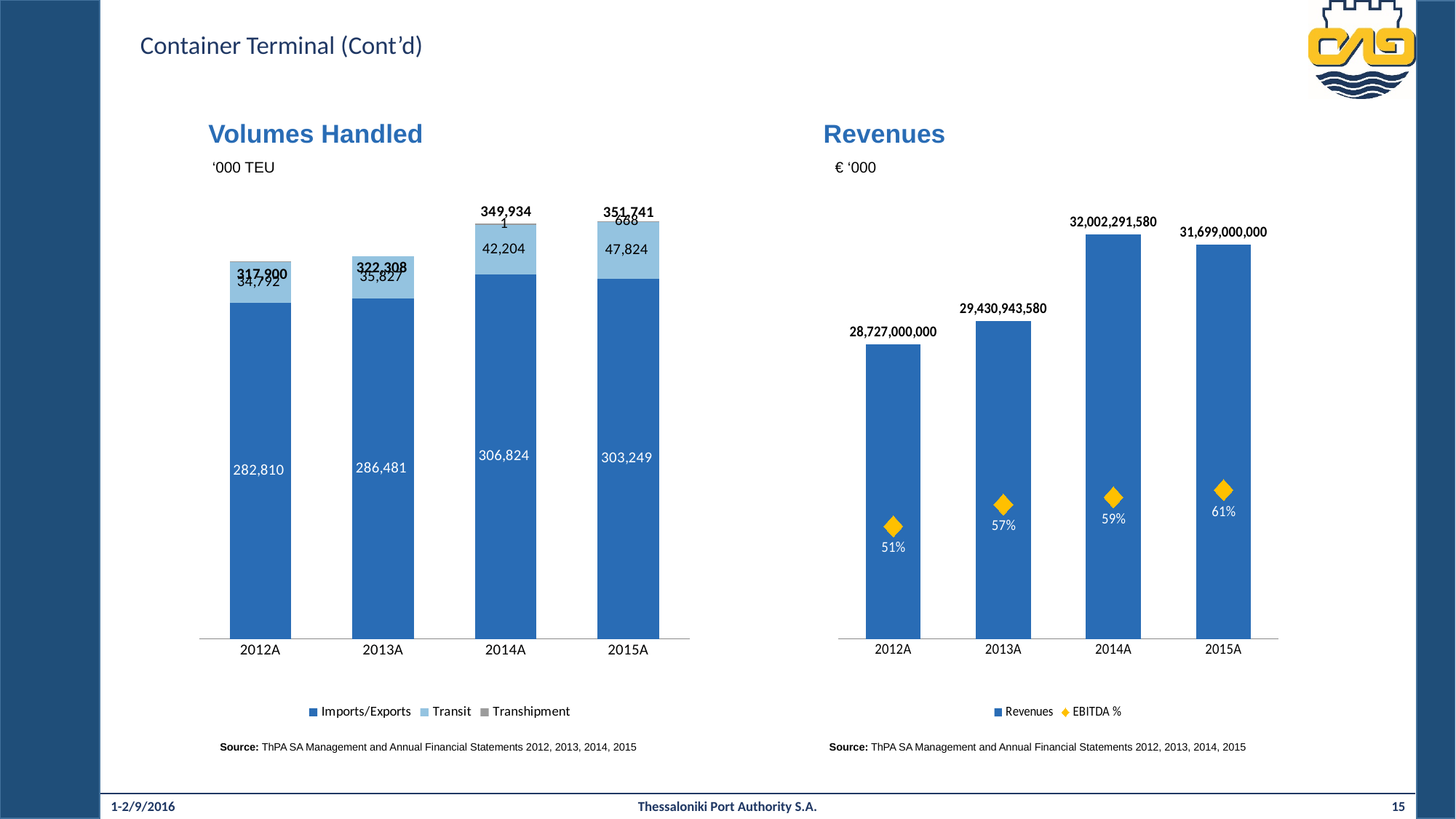
On the Revenues chart, how many series does the legend list? 2 On the Revenues chart, which year has the lowest EBITDA %? 2012A On the Volumes Handled chart, which is larger: Imports/Exports in 2014A or in 2015A? 2014A On the Volumes Handled chart, what is the Imports/Exports value for 2014A? 306,824 On the Volumes Handled chart, what is the total volume shown for 2015A? 351,741 On the Revenues chart, which year has the highest revenue? 2014A On the Revenues chart, what is the revenue value shown for 2014A? 32,002,291,580 On the Volumes Handled chart, what is the Transit value for 2015A? 47,824 On the Volumes Handled chart, how many series does the legend list? 3 On the Volumes Handled chart, what is the difference between the Transit values for 2015A and 2014A? 5,620 On the Revenues chart, does the EBITDA % rise or fall from 2012A to 2015A? rises On the Revenues chart, what is the EBITDA % for 2015A? 61%